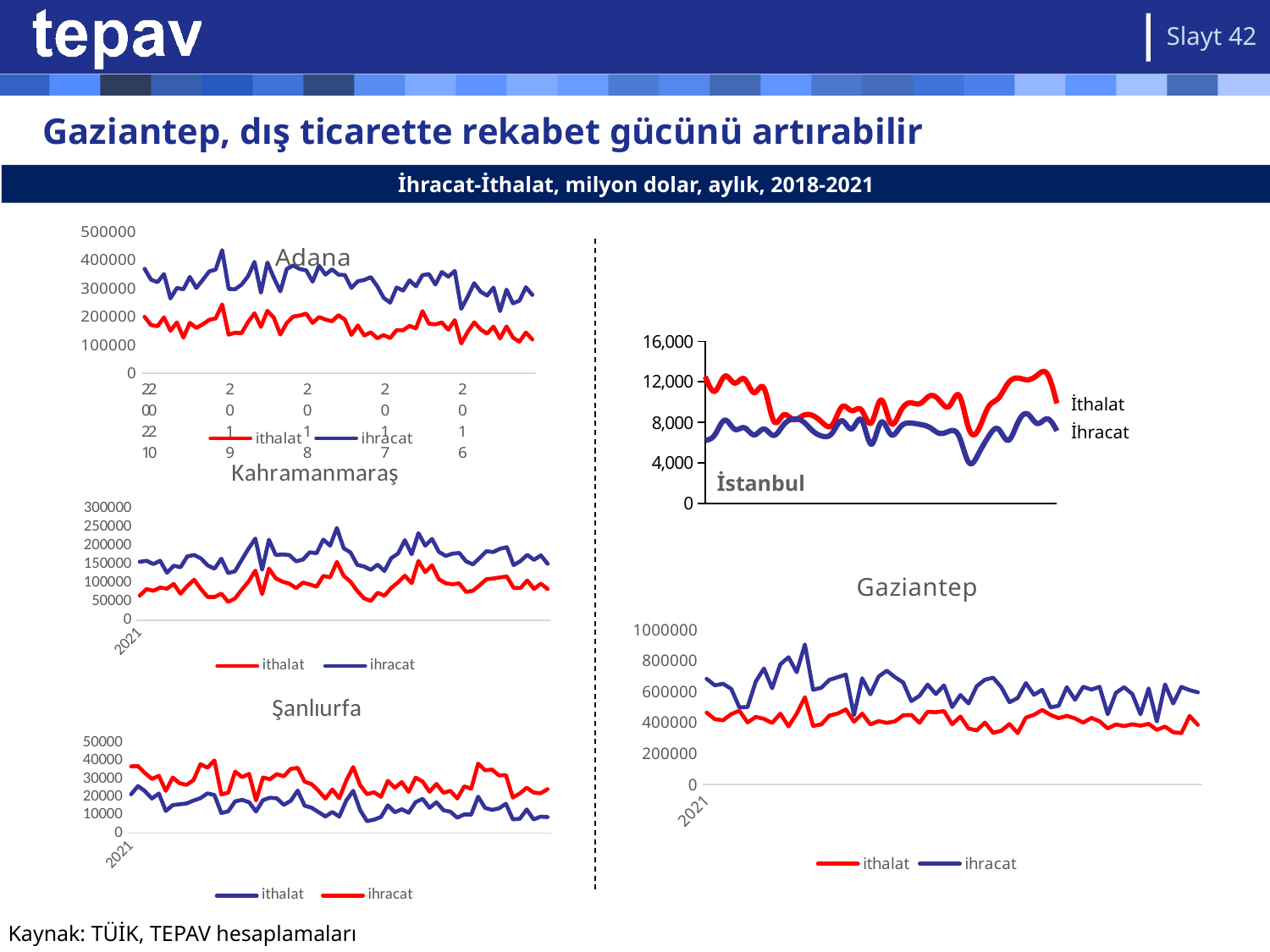
In the Adana chart, is the peak value of ithalat greater or less than 300000? less In the İstanbul chart, which series is higher at the start of the period, İthalat or İhracat? İthalat In the Şanlıurfa chart, which colour represents ithalat according to the legend? blue What kind of chart is the Adana chart? line chart In the İstanbul chart, is the lowest value of İhracat greater or less than 8,000? less In the Gaziantep chart, is the peak value of ihracat greater or less than 800000? greater In the Gaziantep chart, which series is generally higher, ithalat or ihracat? ihracat How many series does the legend of the Gaziantep chart list? 2 How many charts are shown on the slide? 5